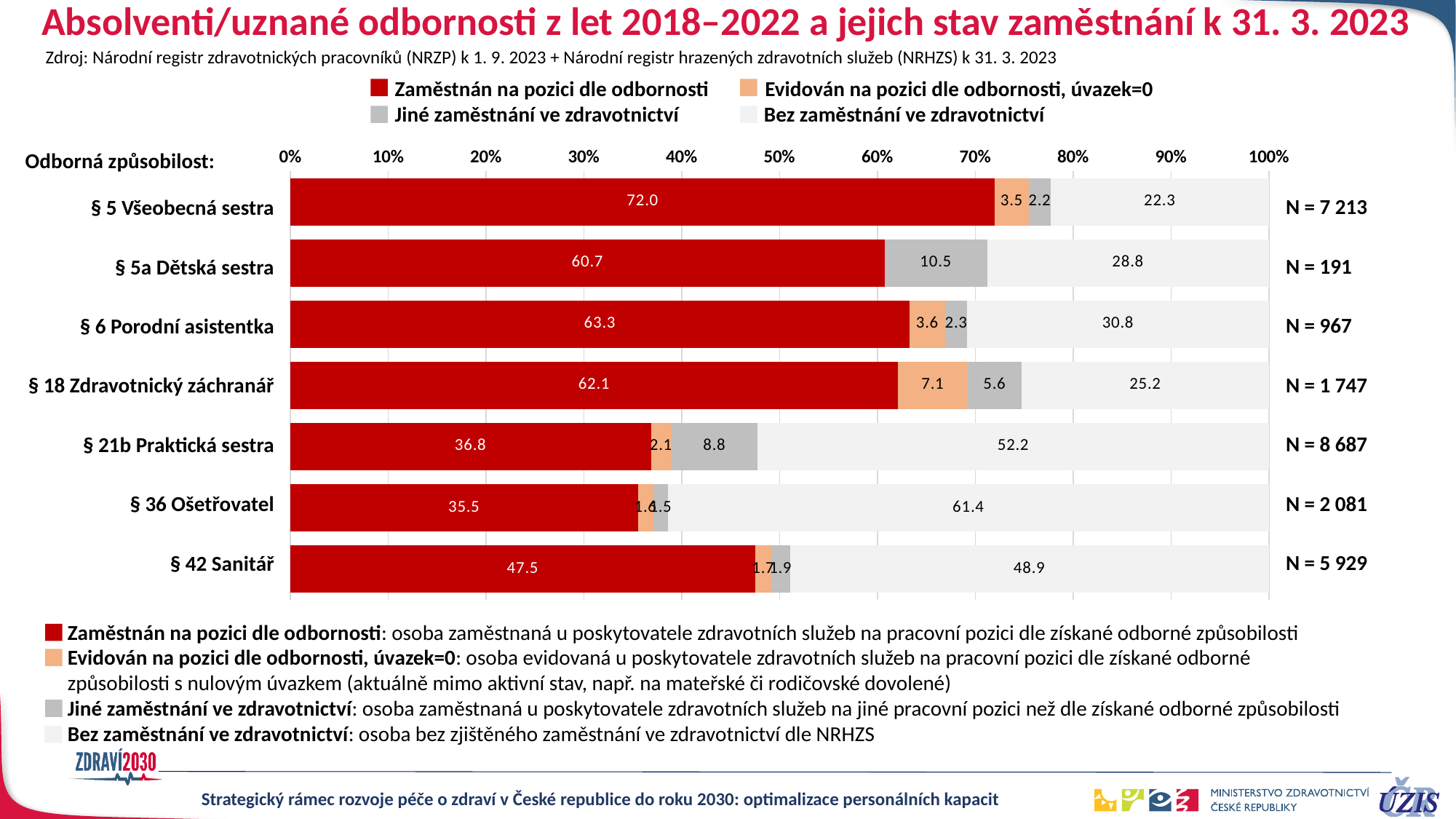
What is the value of 'Bez zaměstnání ve zdravotnictví' for § 21b Praktická sestra? 52.2 Which has a larger 'Jiné zaměstnání ve zdravotnictví' share: § 5a Dětská sestra or § 18 Zdravotnický záchranář? § 5a Dětská sestra How many categories (odborné způsobilosti) are plotted in the chart? 7 What is the N value shown for § 21b Praktická sestra? N = 8 687 What is the value of 'Zaměstnán na pozici dle odbornosti' for § 5 Všeobecná sestra? 72.0 What colour represents 'Zaměstnán na pozici dle odbornosti' in the chart? red How many series does the chart legend list? 4 Which category has the highest share of 'Zaměstnán na pozici dle odbornosti'? § 5 Všeobecná sestra Which category has the lowest share of 'Zaměstnán na pozici dle odbornosti'? § 36 Ošetřovatel Which category has the highest share of 'Bez zaměstnání ve zdravotnictví'? § 36 Ošetřovatel What is the difference between the 'Bez zaměstnání ve zdravotnictví' values for § 36 Ošetřovatel and § 5 Všeobecná sestra? 39.1 What kind of chart is shown on the slide? stacked bar chart